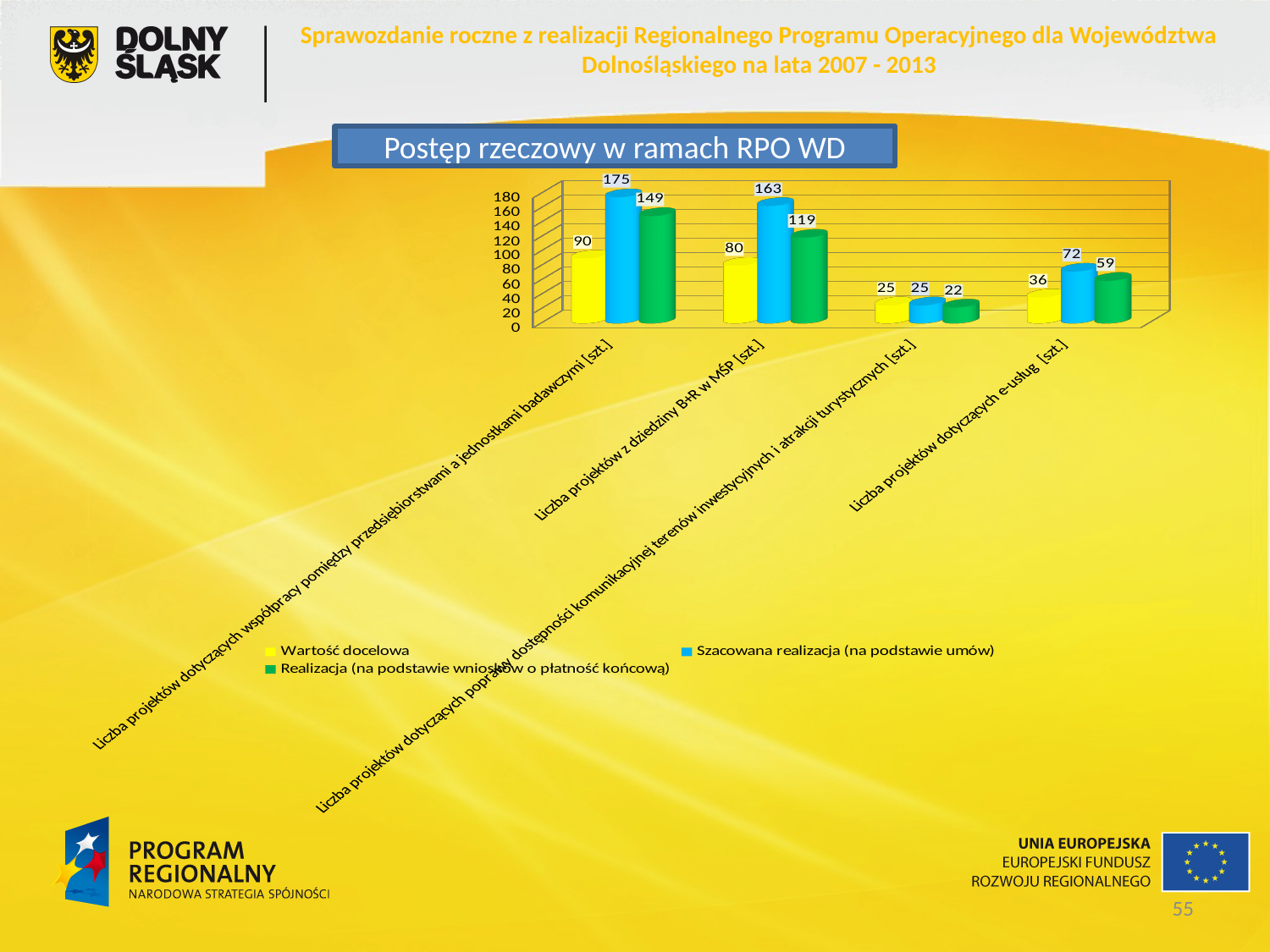
For 'Liczba projektów dotyczących e-usług [szt.]', which is larger: 'Wartość docelowa' or 'Realizacja (na podstawie wniosków o płatność końcową)'? Realizacja (na podstawie wniosków o płatność końcową) Which category has the lowest 'Wartość docelowa' value? Liczba projektów dotyczących poprawy dostępności komunikacyjnej terenów inwestycyjnych i atrakcji turystycznych [szt.] How many categories are shown on the x axis of the chart? 4 What is the 'Wartość docelowa' value for 'Liczba projektów z dziedziny B+R w MŚP [szt.]'? 80 Which series is shown in yellow in the legend? Wartość docelowa What is the 'Realizacja (na podstawie wniosków o płatność końcową)' value for 'Liczba projektów dotyczących współpracy pomiędzy przedsiębiorstwami a jednostkami badawczymi [szt.]'? 149 What is the 'Szacowana realizacja (na podstawie umów)' value for 'Liczba projektów dotyczących e-usług [szt.]'? 72 What kind of chart is shown on the slide? Bar chart What is the difference between the 'Szacowana realizacja (na podstawie umów)' and 'Wartość docelowa' values for 'Liczba projektów z dziedziny B+R w MŚP [szt.]'? 83 How many series does the legend list? 3 What is the title of the chart? Postęp rzeczowy w ramach RPO WD Which category has the highest 'Szacowana realizacja (na podstawie umów)' value? Liczba projektów dotyczących współpracy pomiędzy przedsiębiorstwami a jednostkami badawczymi [szt.]